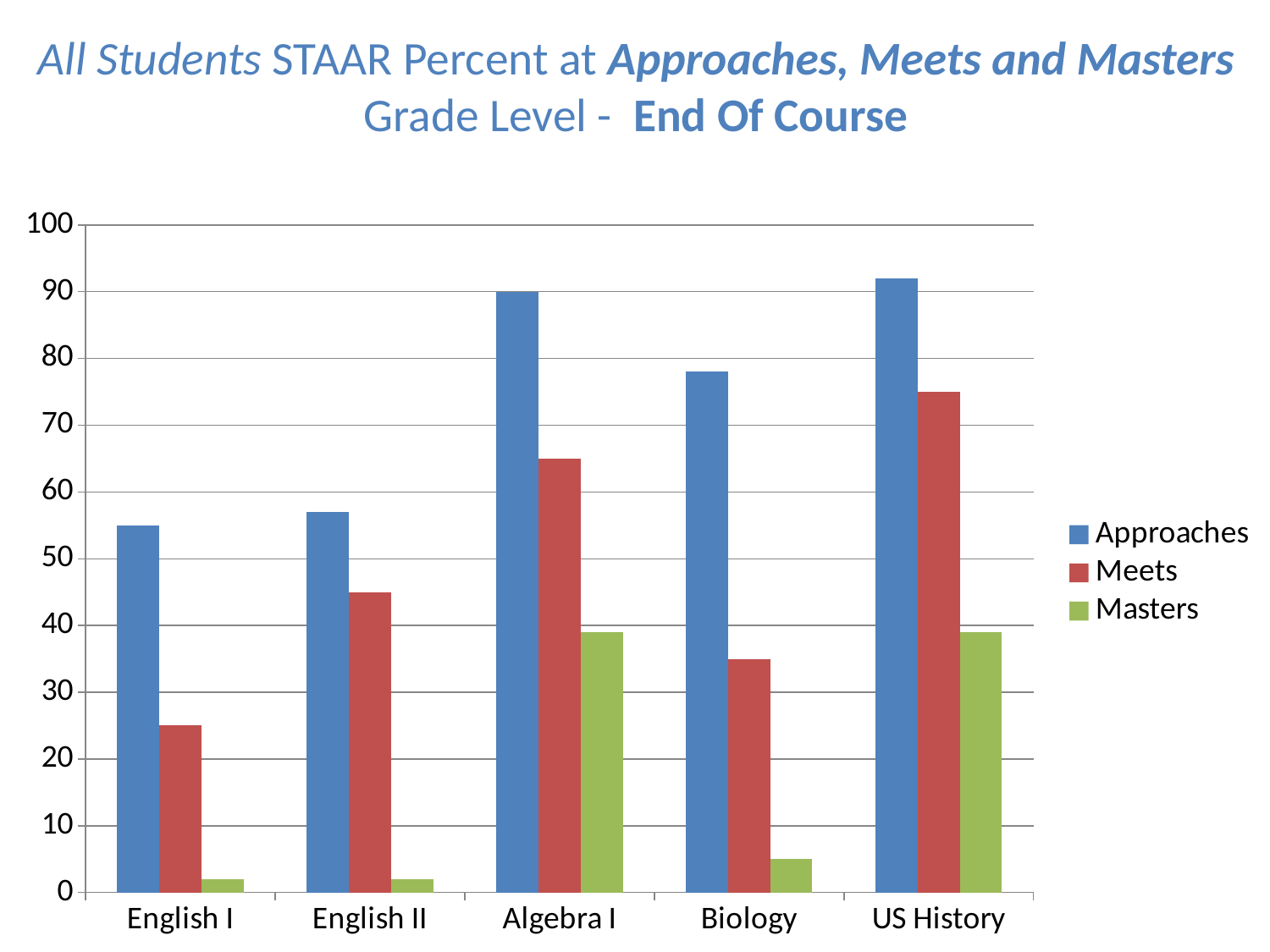
How many series does the chart's legend list? 3 Is the Approaches value for Algebra I greater or less than 80? greater Which is larger, the Meets value for Algebra I or the Meets value for Biology? Algebra I Which is larger, the Masters value for English II or the Masters value for Biology? Biology What kind of chart is shown on the slide? bar chart Which series is shown in green in the chart's legend? Masters How many courses are shown along the x axis of the chart? 5 Is the Meets value for English I greater or less than 30? less Is the Meets value for US History greater or less than 70? greater Which course has the lowest Meets value? English I Which course has the highest Meets value? US History